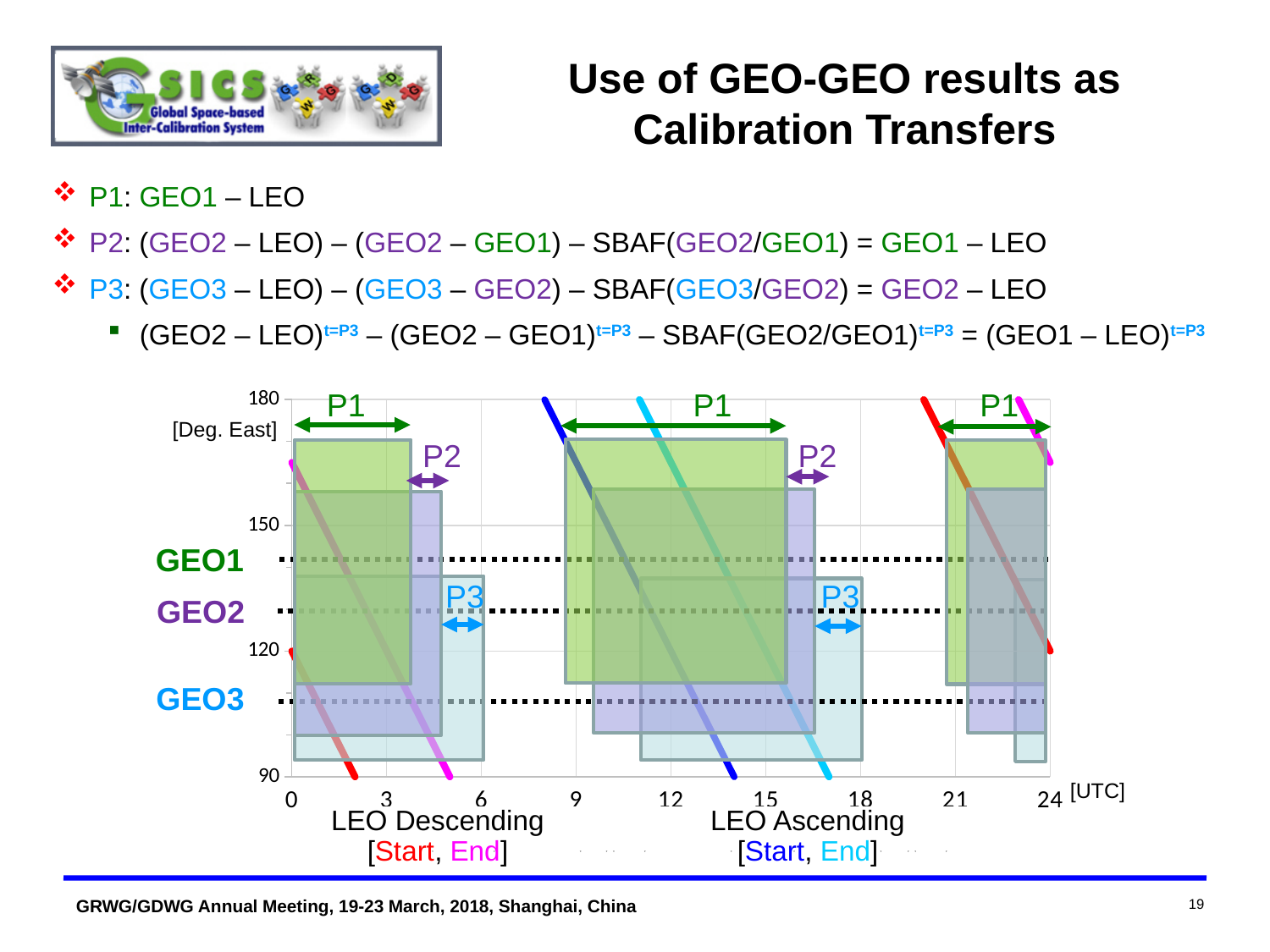
Is the longitude of the GEO3 dotted line greater or less than 120 Deg. East? less Is the longitude of the GEO1 dotted line greater or less than 120 Deg. East? greater How many P1 arrows are drawn on the chart? 3 What is the highest value shown on the y axis of the chart? 180 Which GEO satellite's dotted line is at the lowest longitude on the chart? GEO3 Is the longitude of the GEO1 dotted line greater or less than 150 Deg. East? less What unit is shown on the x axis of the chart? UTC What is the lowest value shown on the x axis of the chart? 0 Which GEO satellite's dotted line is at the highest longitude on the chart? GEO1 What unit is shown on the y axis of the chart? Deg. East How many GEO satellites are marked with dotted horizontal lines on the chart? 3 Which is at a higher longitude on the chart, GEO2 or GEO3? GEO2